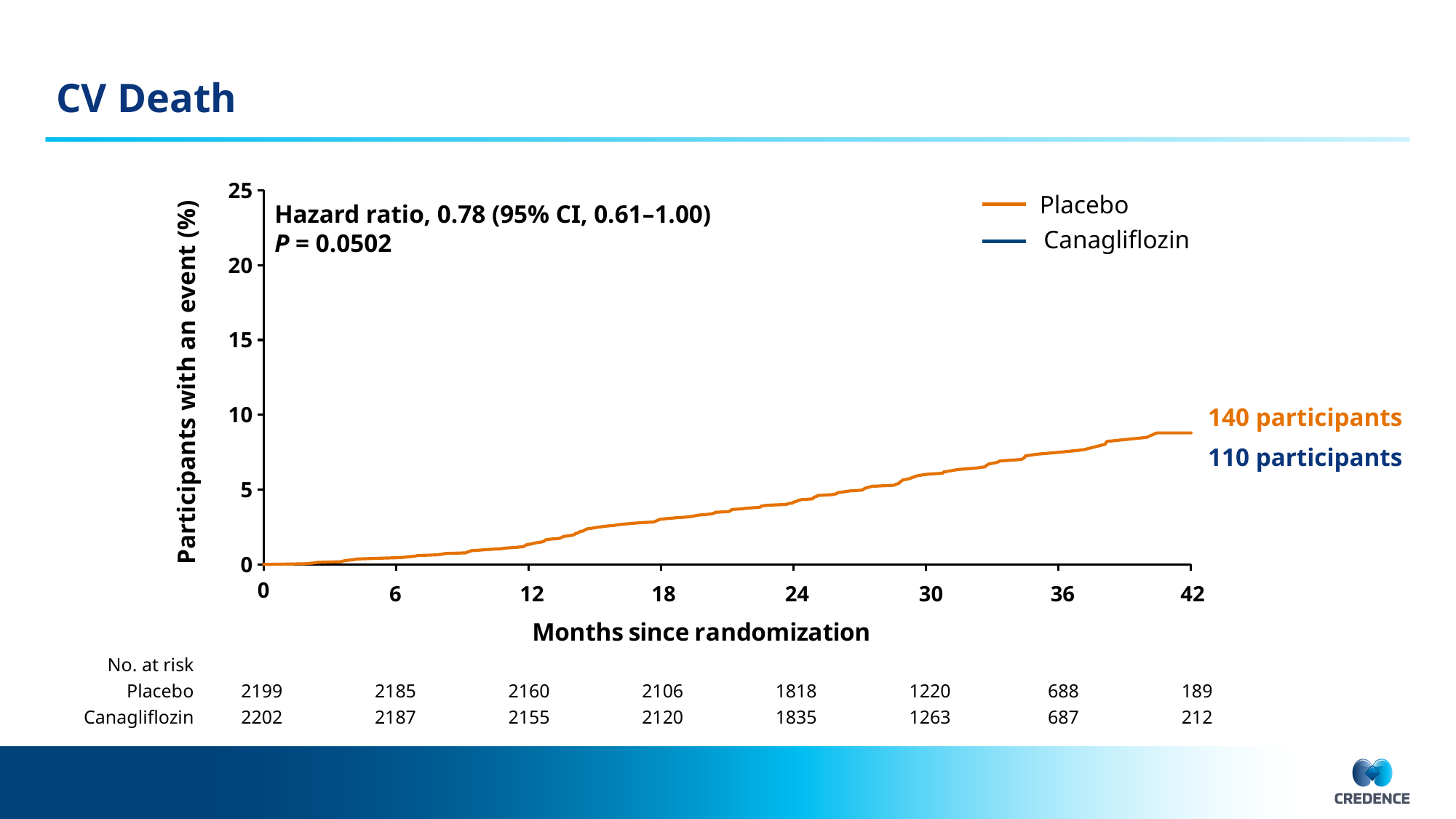
Does the Placebo curve rise or fall as months since randomization increase? Rise How many participants had an event in the Placebo group, according to the annotation? 140 participants Is the Placebo value at 42 months greater or less than 10? less What hazard ratio is printed on the chart? 0.78 (95% CI, 0.61–1.00) What is the number at risk for Placebo at 24 months? 1818 What is the number at risk for Canagliflozin at 42 months? 212 How many participants had an event in the Canagliflozin group, according to the annotation? 110 participants What kind of chart is shown on the slide? Line chart What is the title of the slide's chart? CV Death What P value is printed on the chart? P = 0.0502 What is the label of the y axis? Participants with an event (%) How many series does the legend list? 2